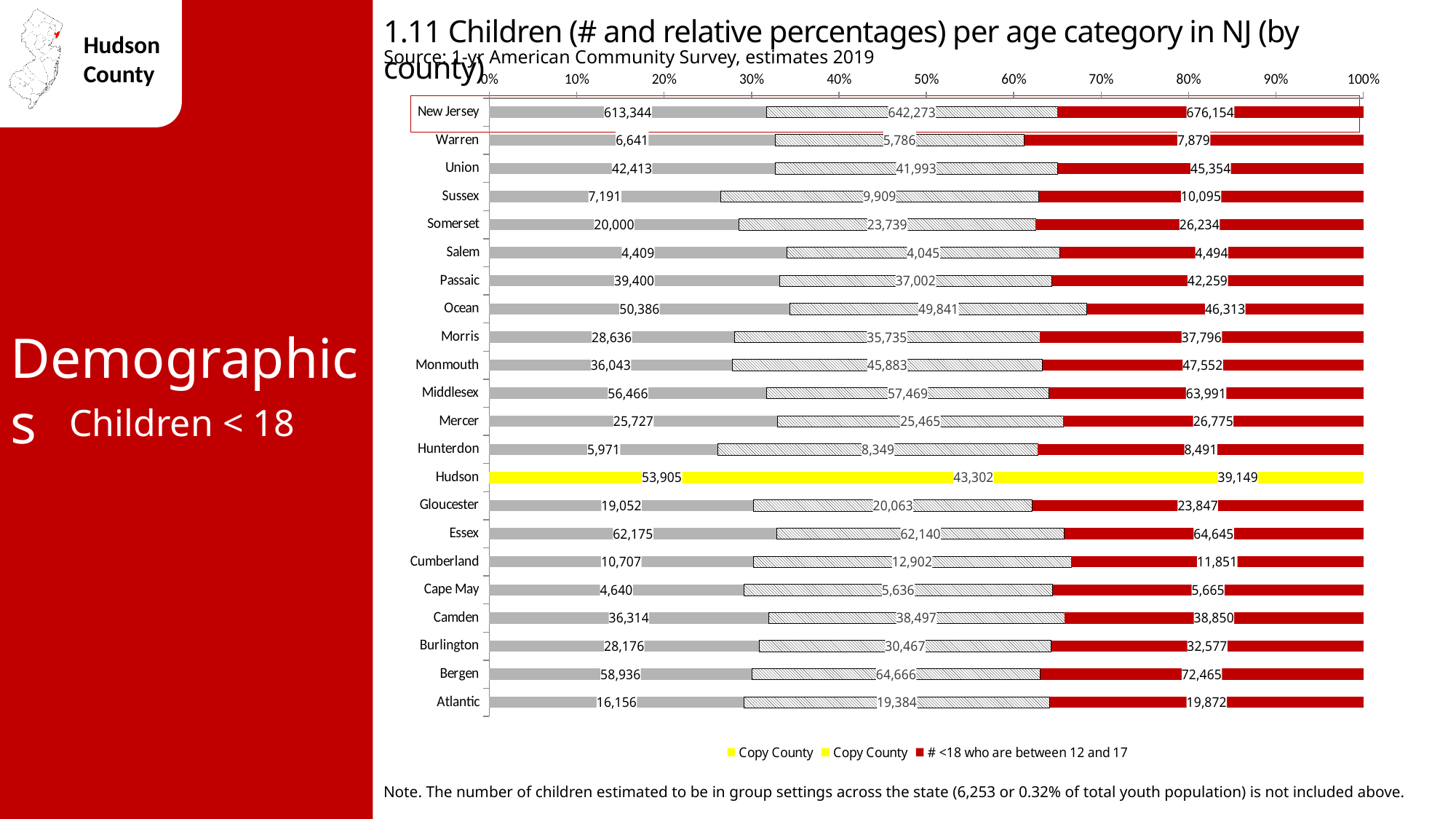
Which has the larger value for the right-hand (12 to 17) segment, Essex or Bergen? Bergen What is the total of the three segments for Hudson? 136,356 What is the value of the left-most segment for Bergen? 58,936 How many rows (New Jersey plus counties) are plotted on the chart? 22 How many series does the legend list? 3 What is the value of the middle segment for Warren? 5,786 Excluding the New Jersey row, which county has the highest value for the right-hand (12 to 17) segment? Bergen Which row of the chart is highlighted in yellow? Hudson What is the value of the right-hand (12 to 17) segment for Hudson? 39,149 Excluding the New Jersey row, which county has the lowest value for the left-most segment? Salem What kind of chart is shown on the slide? Stacked bar chart What is the difference between Hudson's left-most segment (53,905) and its right-hand segment (39,149)? 14,756